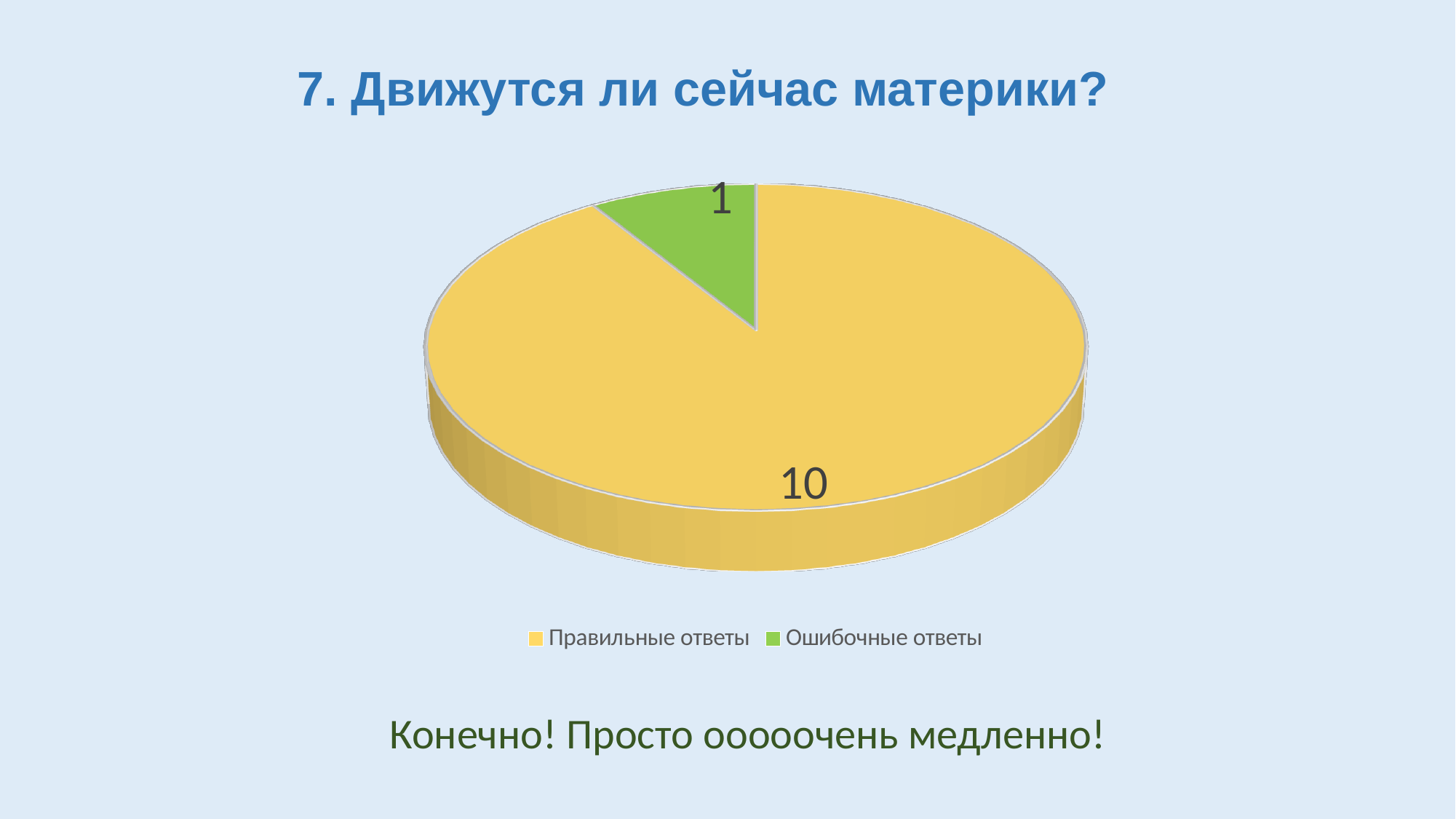
What is the title of the slide above the chart? 7. Движутся ли сейчас материки? What is the value for Правильные ответы? 10 Which category has the smallest slice? Ошибочные ответы What kind of chart is shown on the slide? pie chart How many entries does the legend list? 2 What is the total of all slices in the pie chart? 11 What is the difference between the values for Правильные ответы and Ошибочные ответы? 9 What colour is the slice for Ошибочные ответы? green How many slices does the pie chart have? 2 Which is larger, the value for Правильные ответы or for Ошибочные ответы? Правильные ответы What is the value for Ошибочные ответы? 1 Which category has the largest slice? Правильные ответы